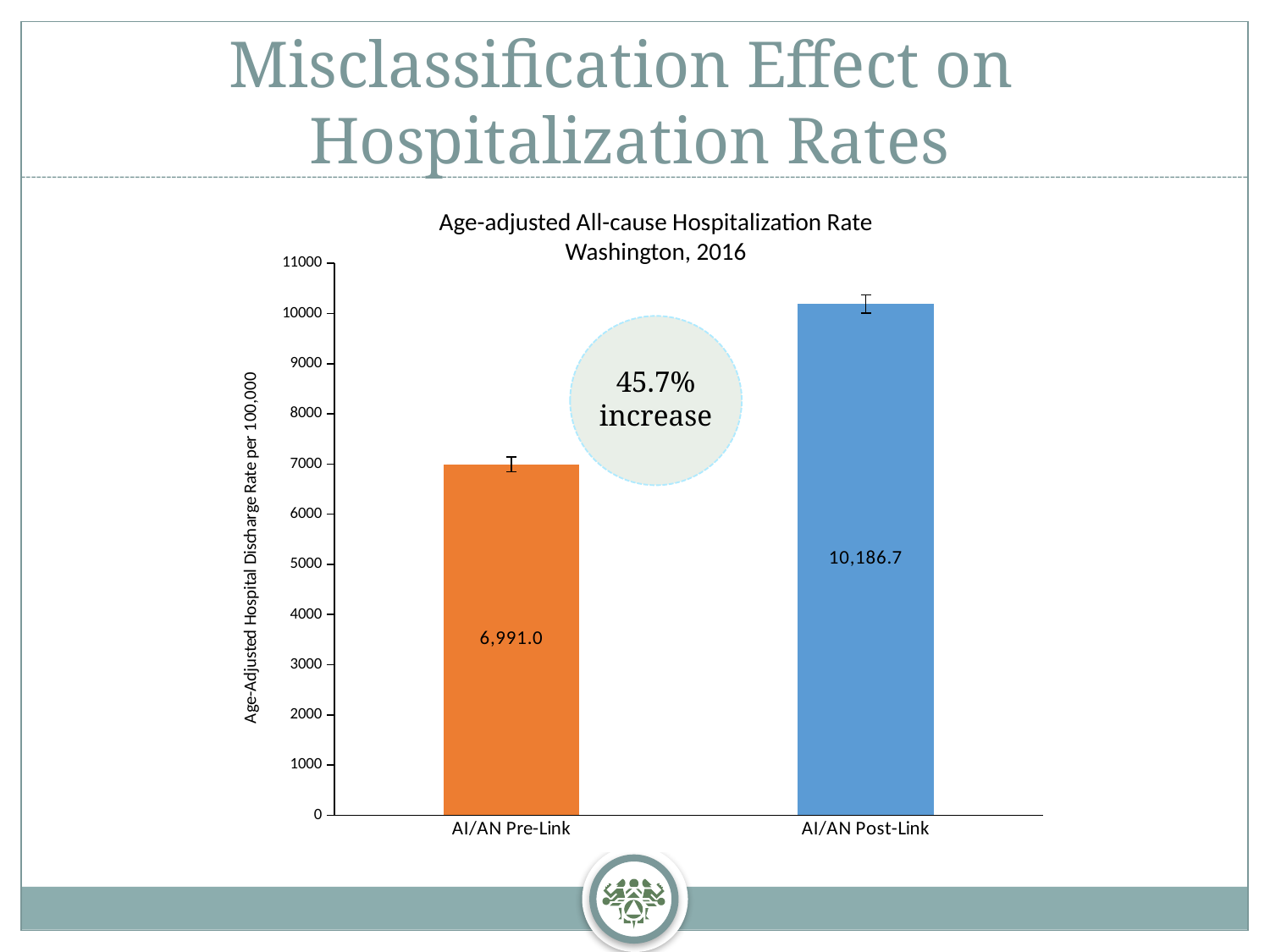
Which category has the highest value? AI/AN Post-Link What kind of chart is shown on the slide? bar chart What is the value for AI/AN Post-Link? 10,186.7 What is the title of the chart? Age-adjusted All-cause Hospitalization Rate Washington, 2016 How many categories are shown on the x axis? 2 Is the value for AI/AN Pre-Link greater or less than 8000? less What is the value for AI/AN Pre-Link? 6,991.0 Which category has the lowest value? AI/AN Pre-Link What is the difference between the AI/AN Post-Link and AI/AN Pre-Link values? 3,195.7 What percentage increase is annotated on the chart? 45.7% Is the value for AI/AN Post-Link greater or less than 10000? greater Which is larger, the value for AI/AN Pre-Link or AI/AN Post-Link? AI/AN Post-Link